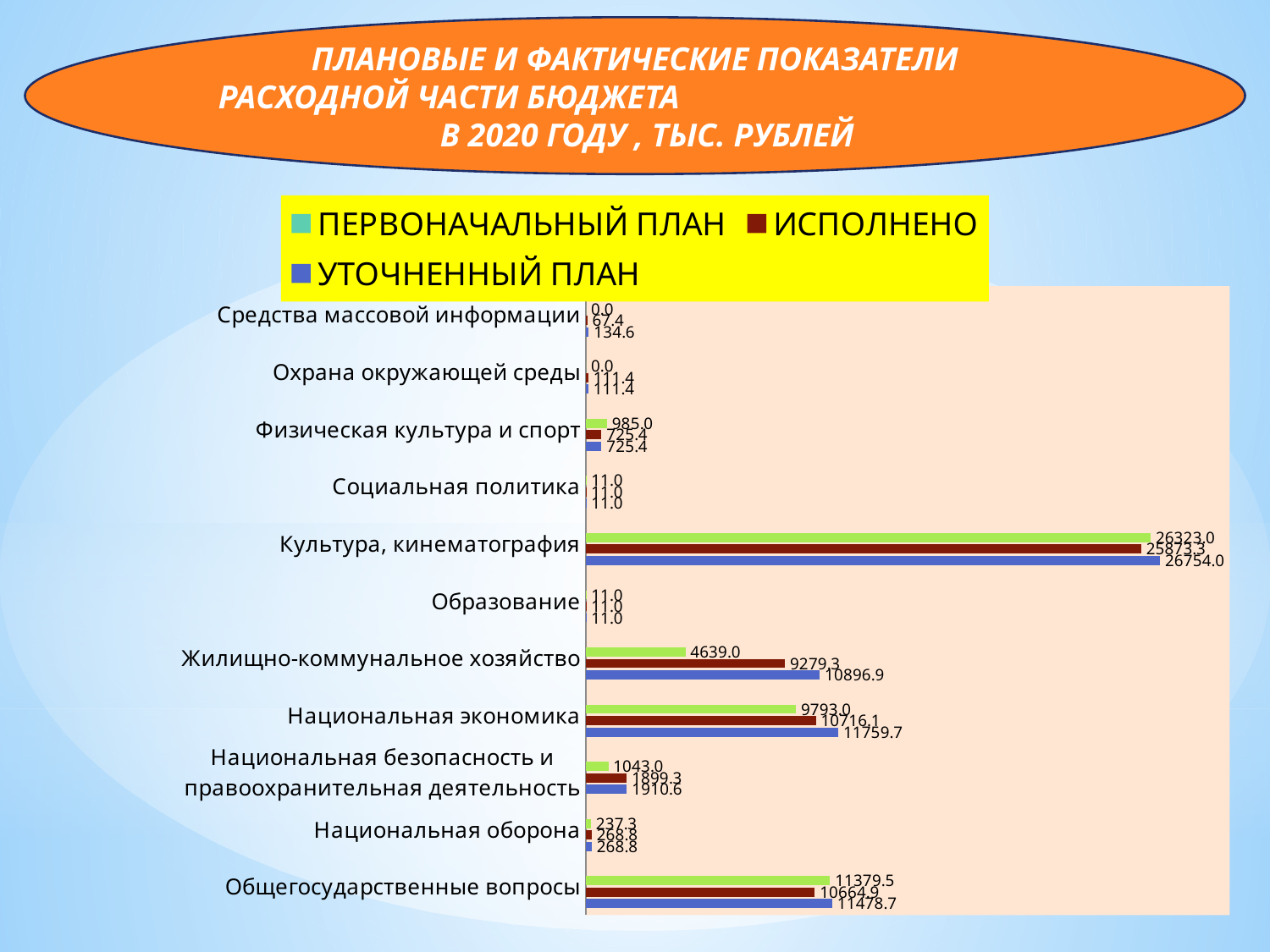
Which category has the highest УТОЧНЕННЫЙ ПЛАН value? Культура, кинематография What is the ИСПОЛНЕНО value for Общегосударственные вопросы? 10664.9 What is the ИСПОЛНЕНО value for Жилищно-коммунальное хозяйство? 9279.3 Which colour represents the ИСПОЛНЕНО series in the legend? dark red What is the difference between the УТОЧНЕННЫЙ ПЛАН and ПЕРВОНАЧАЛЬНЫЙ ПЛАН values for Жилищно-коммунальное хозяйство? 6257.9 What is the УТОЧНЕННЫЙ ПЛАН value for Культура, кинематография? 26754.0 What is the ПЕРВОНАЧАЛЬНЫЙ ПЛАН value for Национальная экономика? 9793.0 What is the difference between the ПЕРВОНАЧАЛЬНЫЙ ПЛАН and ИСПОЛНЕНО values for Физическая культура и спорт? 259.6 How many series does the legend list? 3 How many categories are shown on the chart? 11 What kind of chart is shown on the slide? bar chart Which is larger for Общегосударственные вопросы: the ПЕРВОНАЧАЛЬНЫЙ ПЛАН value or the ИСПОЛНЕНО value? ПЕРВОНАЧАЛЬНЫЙ ПЛАН